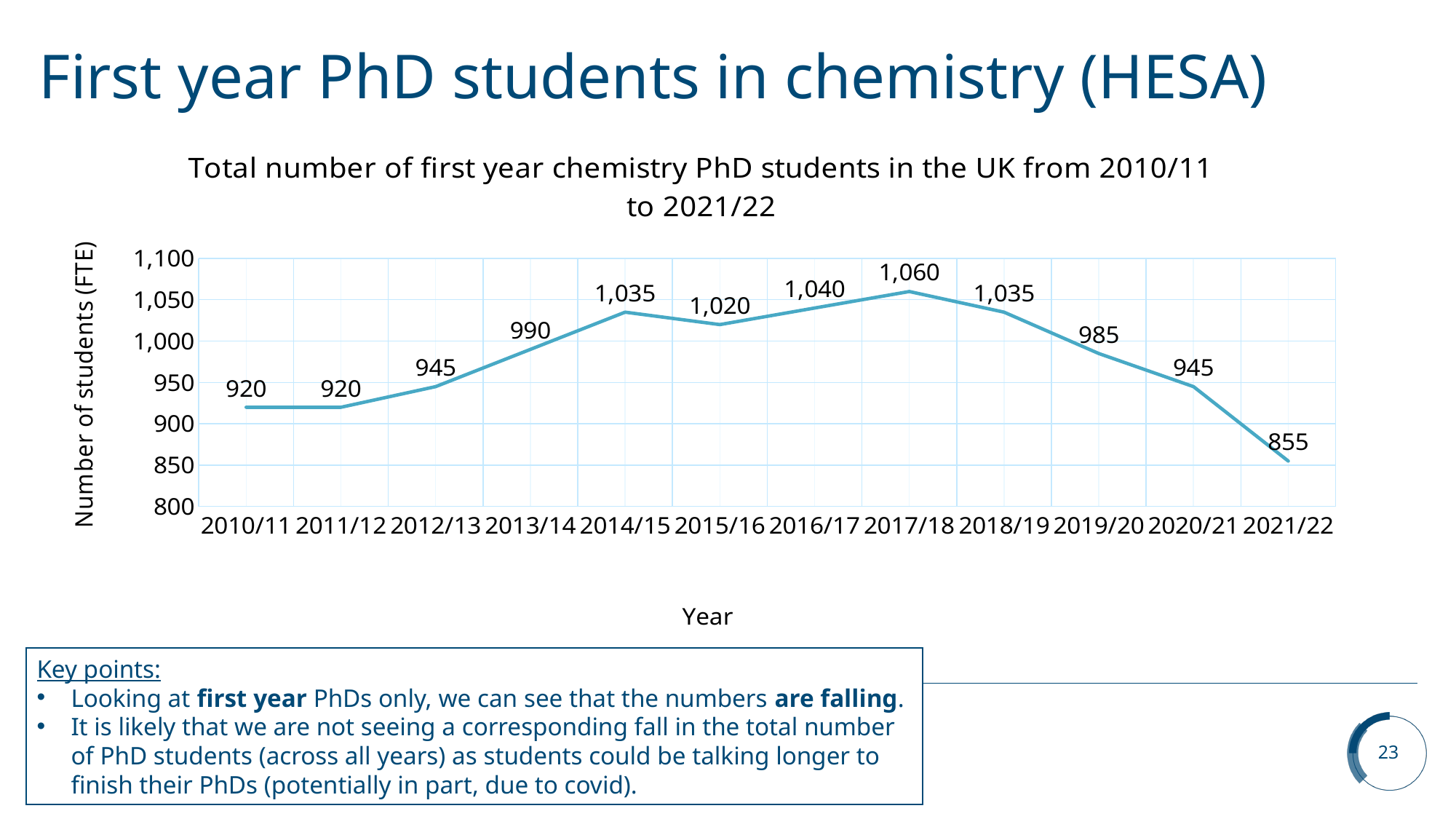
What is the difference between the values for 2017/18 and 2021/22? 205 What kind of chart is shown on the slide? line chart Which year has the highest number of first year chemistry PhD students? 2017/18 What is the difference between the values for 2020/21 and 2021/22? 90 Is the value for 2019/20 greater or less than 1,000? less How many years are plotted on the x axis? 12 What is the value for 2013/14? 990 Do the values rise or fall from 2017/18 to 2021/22? fall Which is larger, the value for 2014/15 or the value for 2015/16? 2014/15 What is the number of first year chemistry PhD students in 2021/22? 855 Which year has the lowest number of first year chemistry PhD students? 2021/22 What is the number of first year chemistry PhD students in 2017/18? 1,060